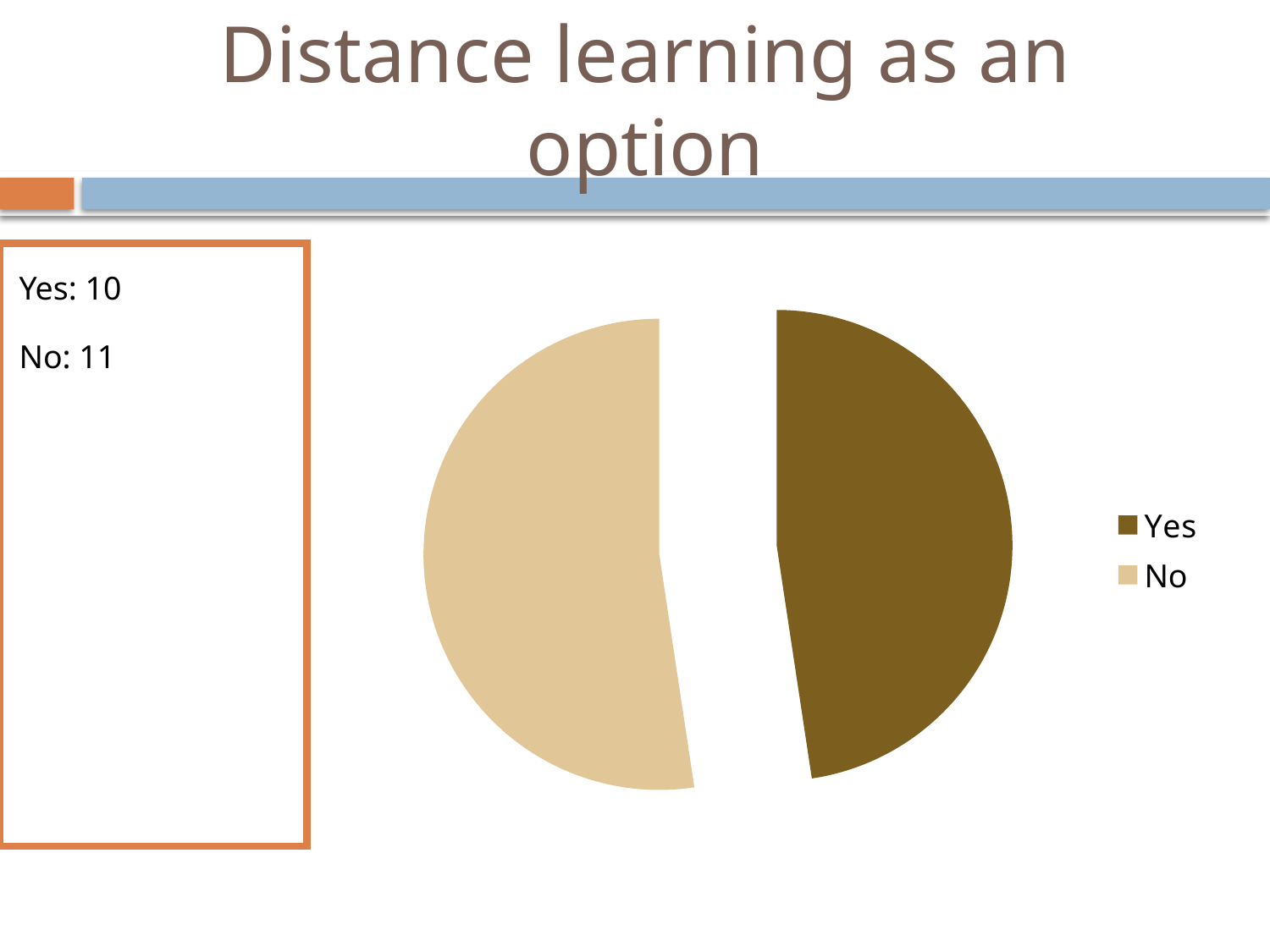
What kind of chart is shown on the slide? pie chart What is the title of the slide containing the pie chart? Distance learning as an option Which category has the larger value, Yes or No? No What is the difference between the values for No and Yes? 1 How many slices does the pie chart have? 2 Which category has the smallest value in the pie chart? Yes What is the value for No shown on the slide? 11 Which legend entry is shown in the darker brown colour? Yes Which category has the largest value in the pie chart? No What is the value for Yes shown on the slide? 10 How many entries does the legend of the pie chart list? 2